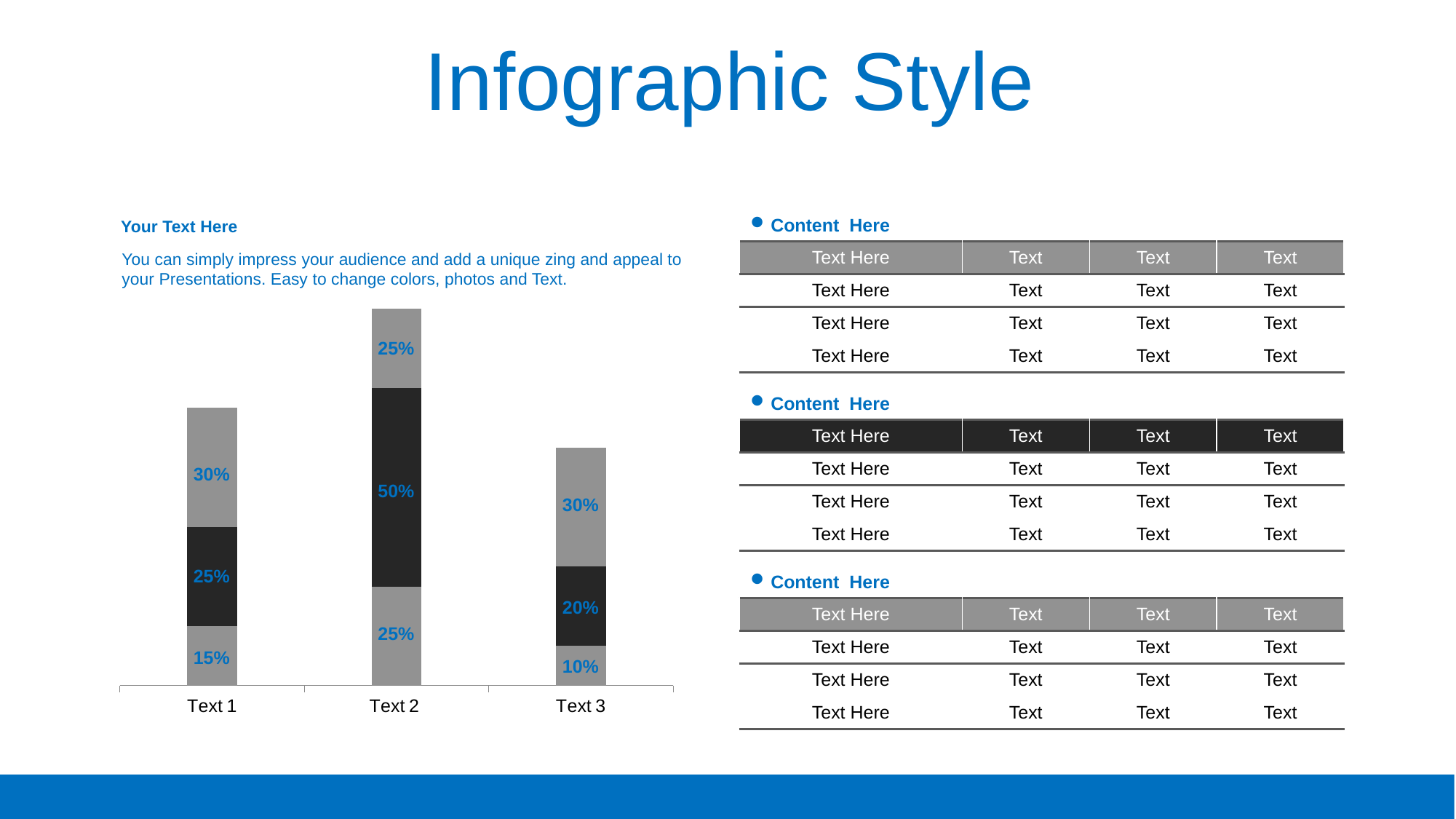
What is the value of the top segment of the Text 3 bar? 30% What is the value of the dark middle segment of the Text 2 bar? 50% Which is larger: the bottom segment of Text 2 or the bottom segment of Text 3? Text 2 What type of chart is shown on the left of the slide? stacked bar chart How many categories are shown on the x axis of the bar chart? 3 What is the total of the stacked bar for Text 1? 70% What is the value of the dark middle segment of the Text 3 bar? 20% Which category has the shortest stacked bar? Text 3 What is the value of the bottom segment of the Text 1 bar? 15% What is the difference between the dark middle segment of Text 2 and the dark middle segment of Text 1? 25% Which category has the tallest stacked bar? Text 2